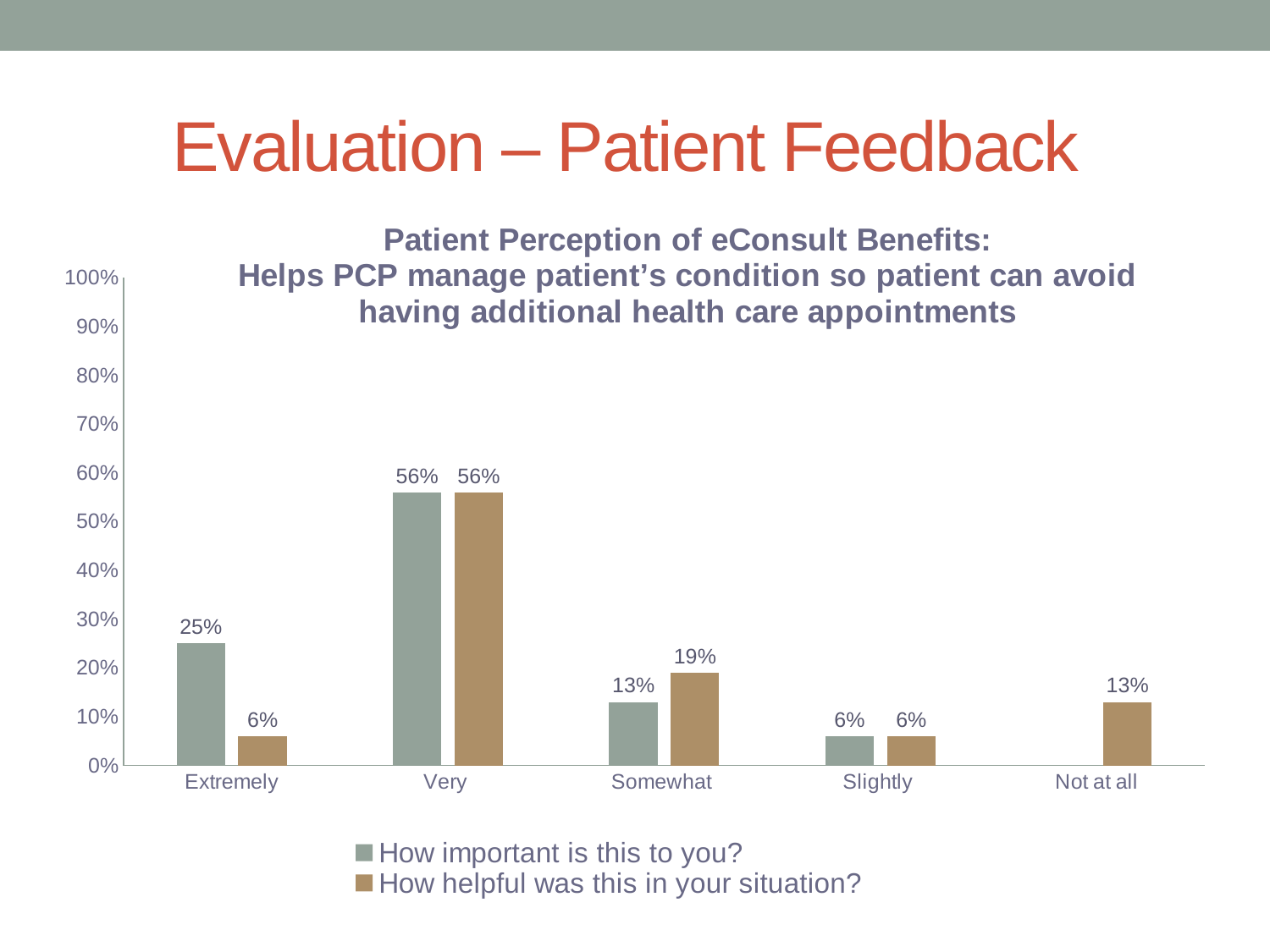
What is the difference between the two series for the 'Extremely' category? 19% What is the value for 'Very' in the 'How important is this to you?' series? 56% What kind of chart is shown on the slide? Bar chart What is the value for 'Somewhat' in the 'How helpful was this in your situation?' series? 19% How many series does the legend list? 2 What is the first line of the chart title? Patient Perception of eConsult Benefits: What is the value for 'Extremely' in the 'How important is this to you?' series? 25% Which category has the highest value in the 'How helpful was this in your situation?' series? Very What is the value for 'Not at all' in the 'How helpful was this in your situation?' series? 13% For the 'Somewhat' category, which series has the larger value? How helpful was this in your situation? How many categories are shown on the x axis? 5